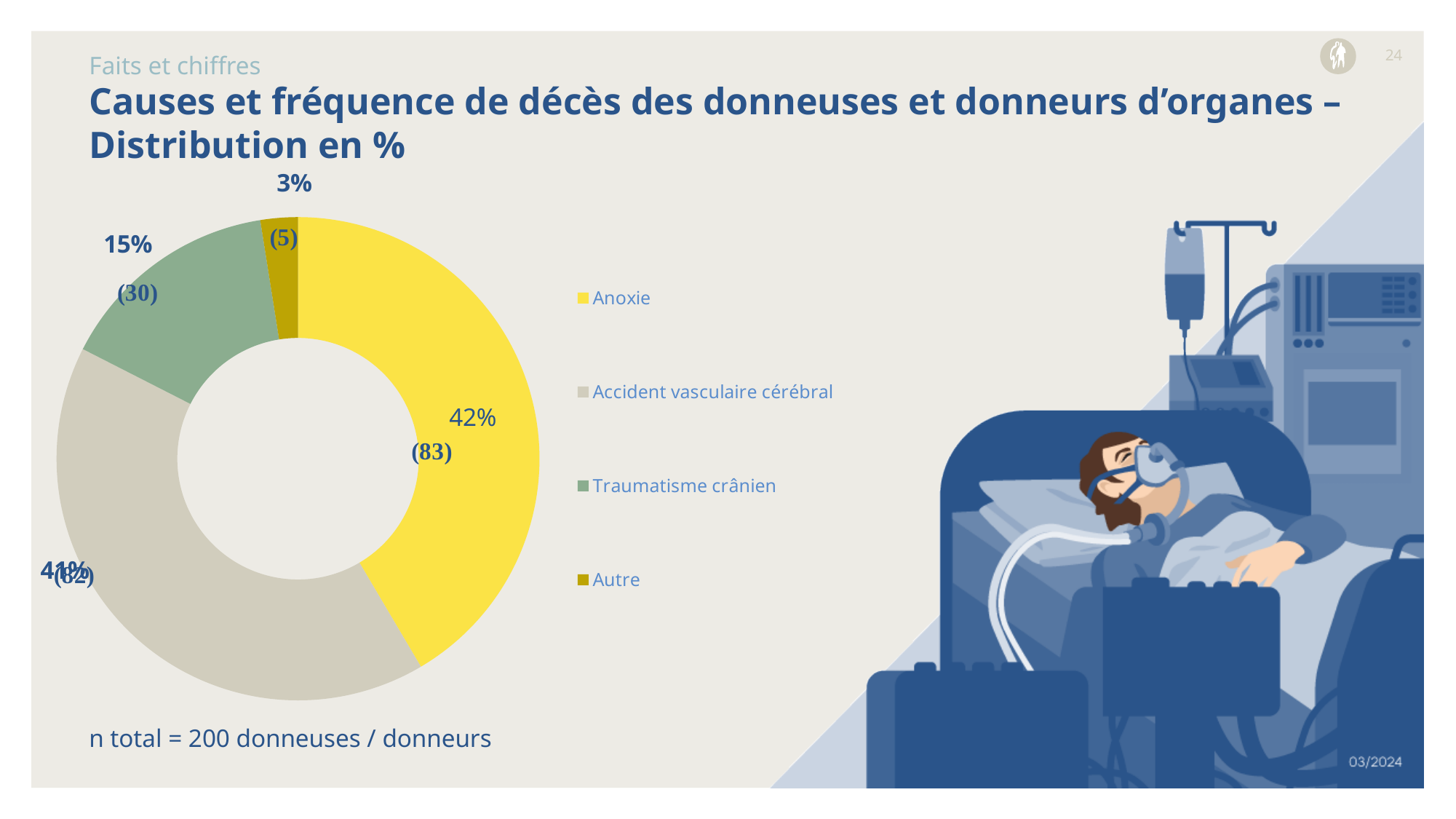
What is the difference in percentage points between Traumatisme crânien and Autre? 12 percentage points What kind of chart is shown on the slide? pie chart (donut) How many donors are in the Traumatisme crânien category, according to the number in parentheses? 30 How many categories does the legend of the chart list? 4 What percentage of the donor deaths is attributed to Anoxie? 42% Which has the larger share: Traumatisme crânien or Autre? Traumatisme crânien How many donors are in the Autre category, according to the number in parentheses? 5 What is the total number of donors (n total) stated below the chart? 200 How many donors are in the Anoxie category, according to the number in parentheses? 83 Which cause of death has the smallest share of the chart? Autre What percentage of the donor deaths is attributed to Traumatisme crânien? 15% What percentage of the donor deaths is attributed to Autre? 3%